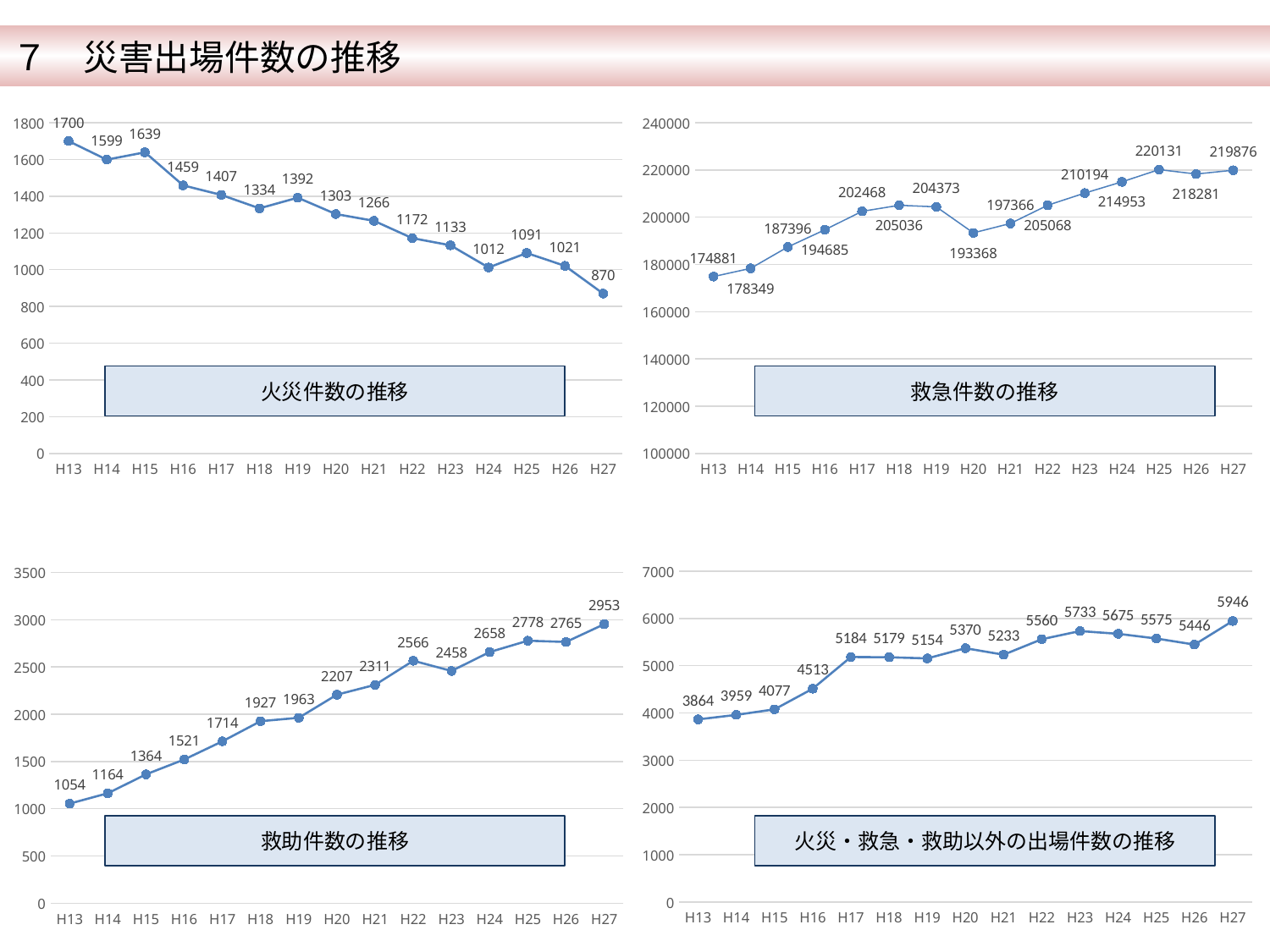
In the 火災・救急・救助以外の出場件数の推移 chart, what is the value for H16? 4513 What type of chart is the 火災・救急・救助以外の出場件数の推移 chart? line chart In the 救助件数の推移 chart, which is larger, the value for H22 or the value for H23? H22 In the 救急件数の推移 chart, which year has the lowest value? H13 In the 火災件数の推移 chart, what is the value for H27? 870 In the 火災・救急・救助以外の出場件数の推移 chart, which year has the highest value? H27 In the 救助件数の推移 chart, how many data points are plotted? 15 In the 救助件数の推移 chart, what is the value for H20? 2207 In the 救急件数の推移 chart, what is the difference between the H27 value and the H13 value? 44995 In the 火災件数の推移 chart, which year has the highest value? H13 In the 救急件数の推移 chart, what is the value for H25? 220131 In the 火災件数の推移 chart, do the values generally rise or fall from H13 to H27? fall